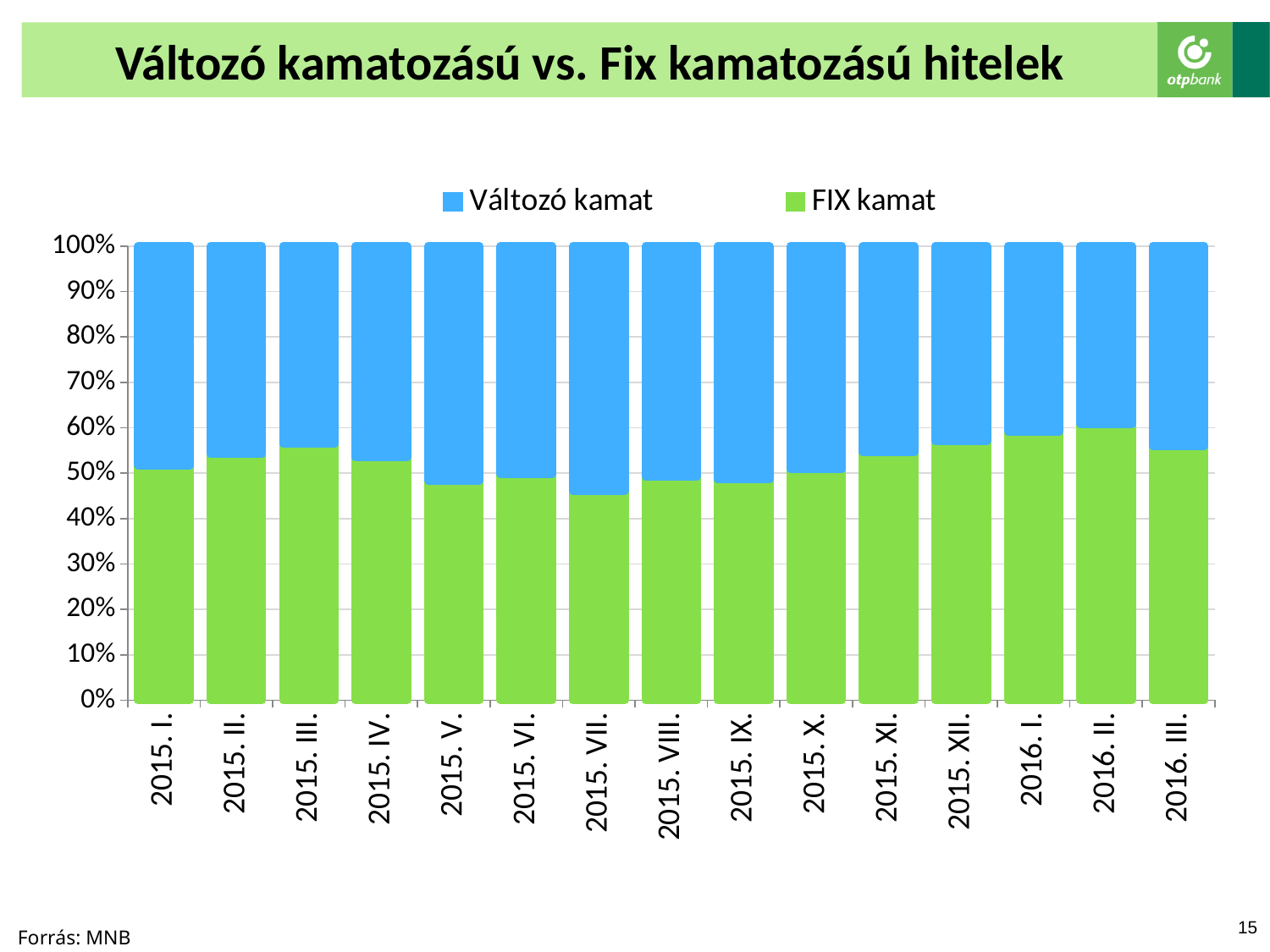
Is the Változó kamat share for 2015. V. greater or less than 50%? greater Which has the larger FIX kamat share, 2015. III. or 2015. V.? 2015. III. Which period has the highest Változó kamat share? 2015. VII. Does the FIX kamat share rise or fall from 2015. VII. to 2016. II.? rise How many periods (categories) are shown on the x axis? 15 Is the FIX kamat share for 2016. II. greater or less than 50%? greater How many series does the legend list? 2 Is the FIX kamat share for 2015. VII. greater or less than 50%? less Which period has the lowest FIX kamat share? 2015. VII. What kind of chart is shown on the slide? stacked bar chart What is the total of the stacked bar for 2015. I.? 100% Which colour represents FIX kamat in the chart? green